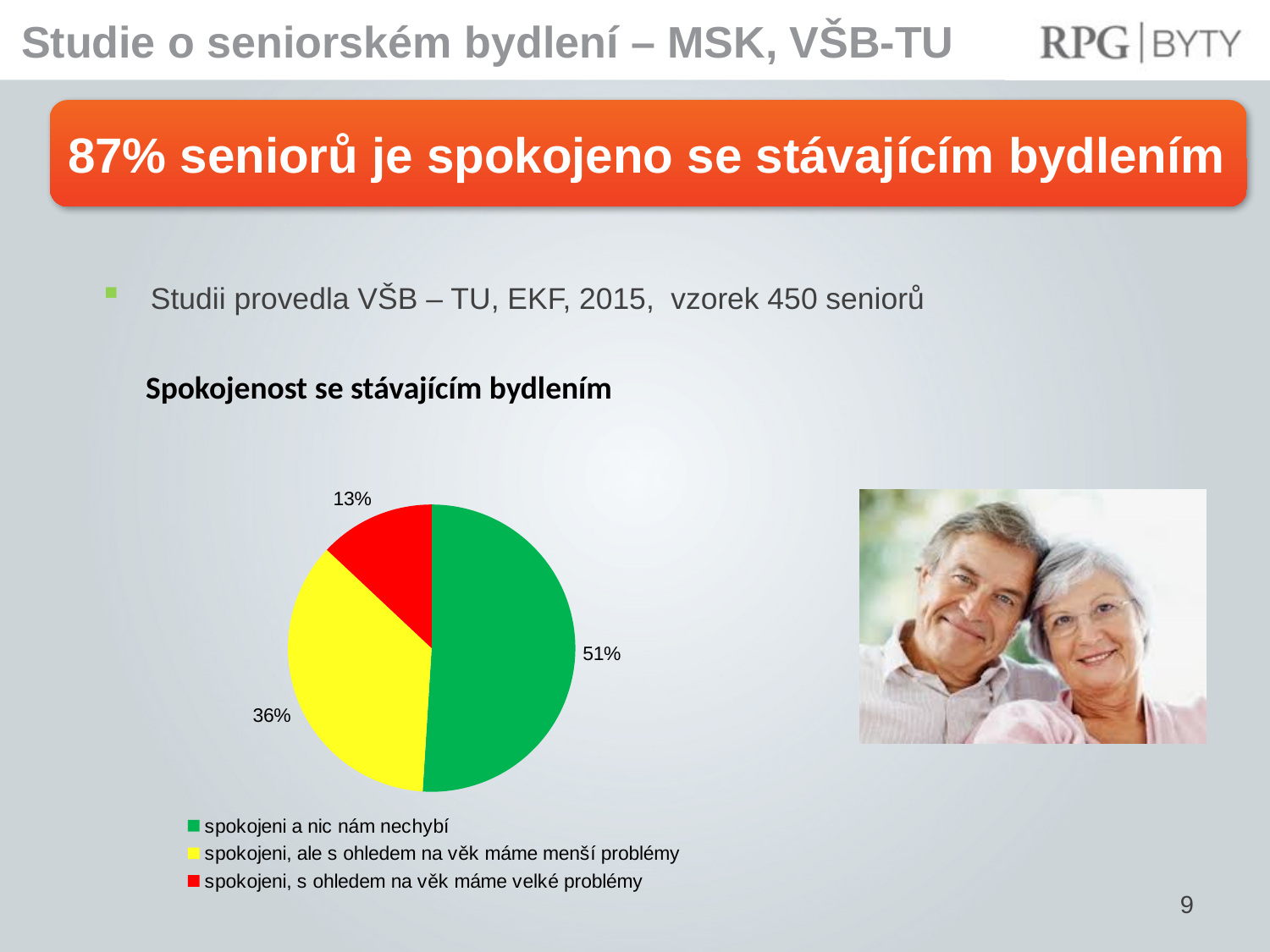
Which category has the smallest slice of the pie? spokojeni, s ohledem na věk máme velké problémy What share of the pie is 'spokojeni, ale s ohledem na věk máme menší problémy'? 36% What share of the pie is 'spokojeni, s ohledem na věk máme velké problémy'? 13% What kind of chart is shown on the slide? pie chart What is the combined share of the 'spokojeni a nic nám nechybí' and 'spokojeni, ale s ohledem na věk máme menší problémy' slices? 87% What is the difference between the 'spokojeni a nic nám nechybí' slice and the 'spokojeni, ale s ohledem na věk máme menší problémy' slice? 15% What colour is the slice for 'spokojeni, s ohledem na věk máme velké problémy'? red How many slices does the pie chart have? 3 Which category has the largest slice of the pie? spokojeni a nic nám nechybí Which is larger: the 'spokojeni, ale s ohledem na věk máme menší problémy' slice or the 'spokojeni, s ohledem na věk máme velké problémy' slice? spokojeni, ale s ohledem na věk máme menší problémy What share of the pie is 'spokojeni a nic nám nechybí'? 51% What is the title of the chart? Spokojenost se stávajícím bydlením